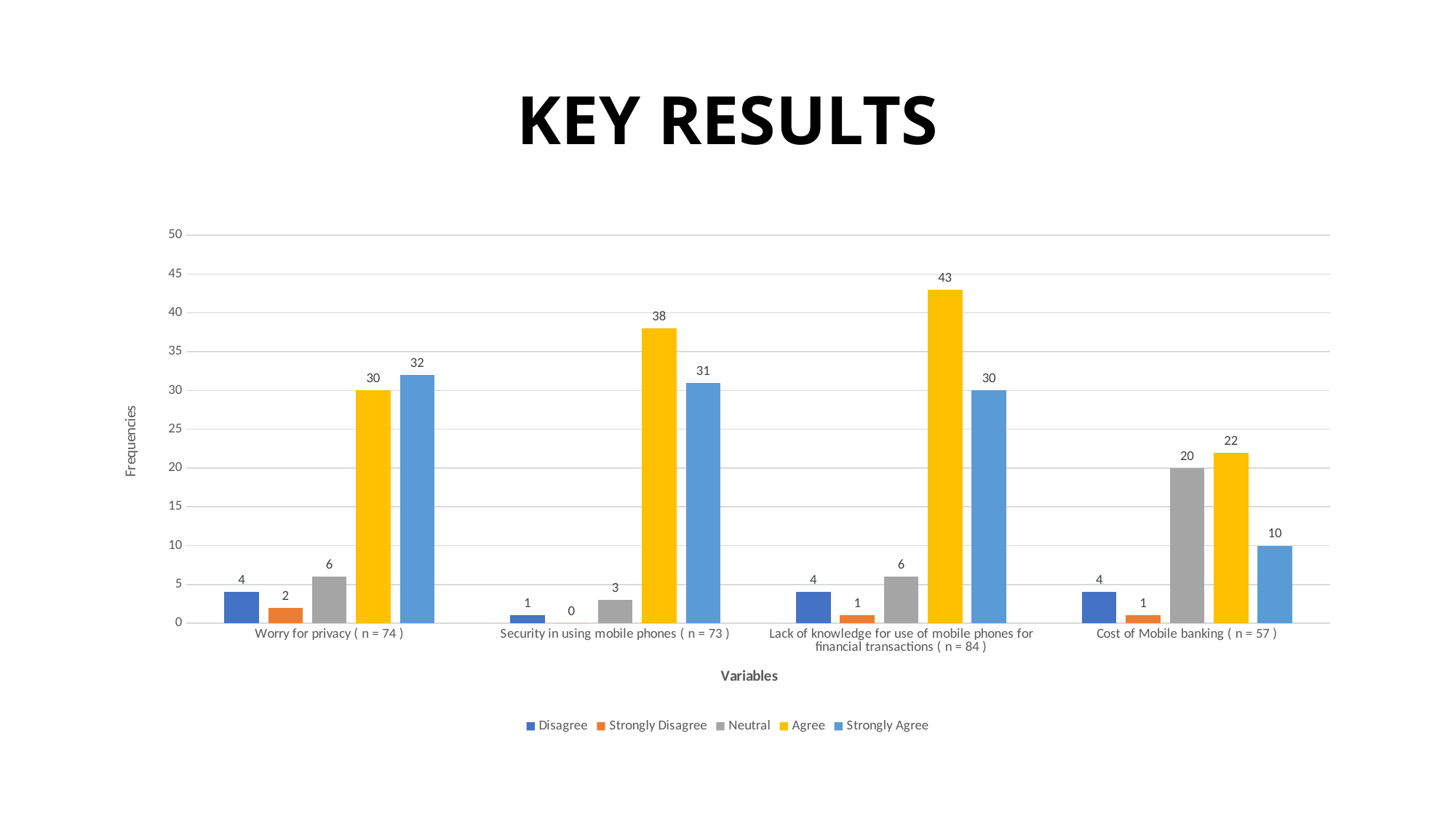
What is the difference between the Agree and Strongly Agree values for Security in using mobile phones ( n = 73 )? 7 What is the Strongly Disagree value for Security in using mobile phones ( n = 73 )? 0 How many series does the legend list? 5 Which category has the lowest Strongly Agree value? Cost of Mobile banking ( n = 57 ) What kind of chart is shown on the slide? Bar chart What is the Agree value for Lack of knowledge for use of mobile phones for financial transactions ( n = 84 )? 43 How many categories are shown on the x axis? 4 What is the label of the vertical axis? Frequencies What is the Neutral value for Cost of Mobile banking ( n = 57 )? 20 Which category has the highest Agree value? Lack of knowledge for use of mobile phones for financial transactions ( n = 84 ) What is the Strongly Agree value for Worry for privacy ( n = 74 )? 32 Which is larger for Cost of Mobile banking ( n = 57 ): the Neutral value or the Strongly Agree value? Neutral